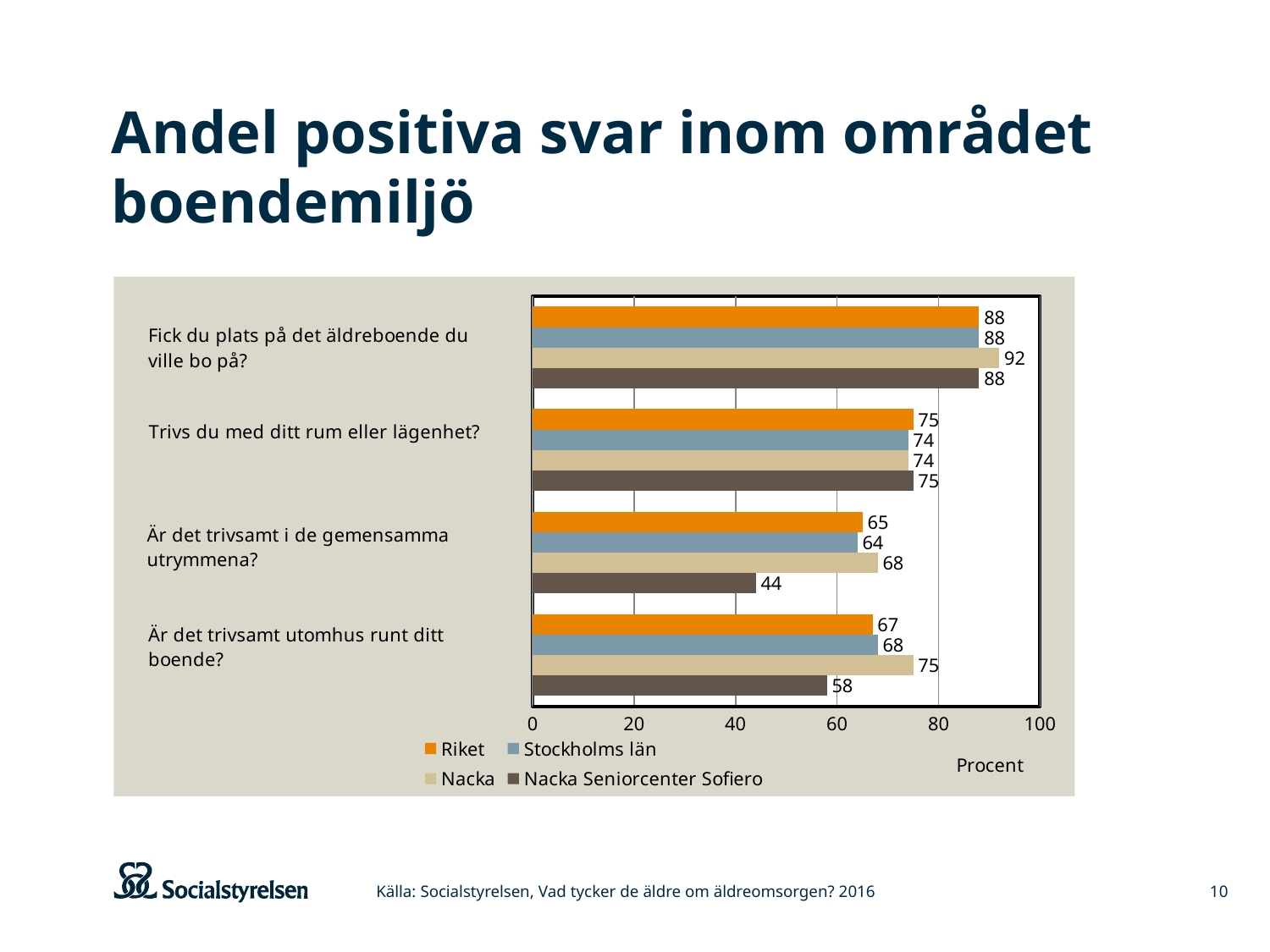
What is the value for Nacka Seniorcenter Sofiero for "Är det trivsamt i de gemensamma utrymmena?"? 44 What is the value for Nacka for "Fick du plats på det äldreboende du ville bo på?"? 92 For "Är det trivsamt utomhus runt ditt boende?", which is larger: the value for Nacka or the value for Stockholms län? Nacka How many series does the legend list? 4 What is the difference between the Nacka value and the Nacka Seniorcenter Sofiero value for "Är det trivsamt i de gemensamma utrymmena?"? 24 What is the value for Riket for "Är det trivsamt utomhus runt ditt boende?"? 67 What is the label on the horizontal axis of the chart? Procent How many question categories are shown on the chart? 4 Which series has the lowest value for "Är det trivsamt utomhus runt ditt boende?"? Nacka Seniorcenter Sofiero Which series has the highest value for "Fick du plats på det äldreboende du ville bo på?"? Nacka What is the value for Stockholms län for "Trivs du med ditt rum eller lägenhet?"? 74 What kind of chart is shown on the slide? Bar chart